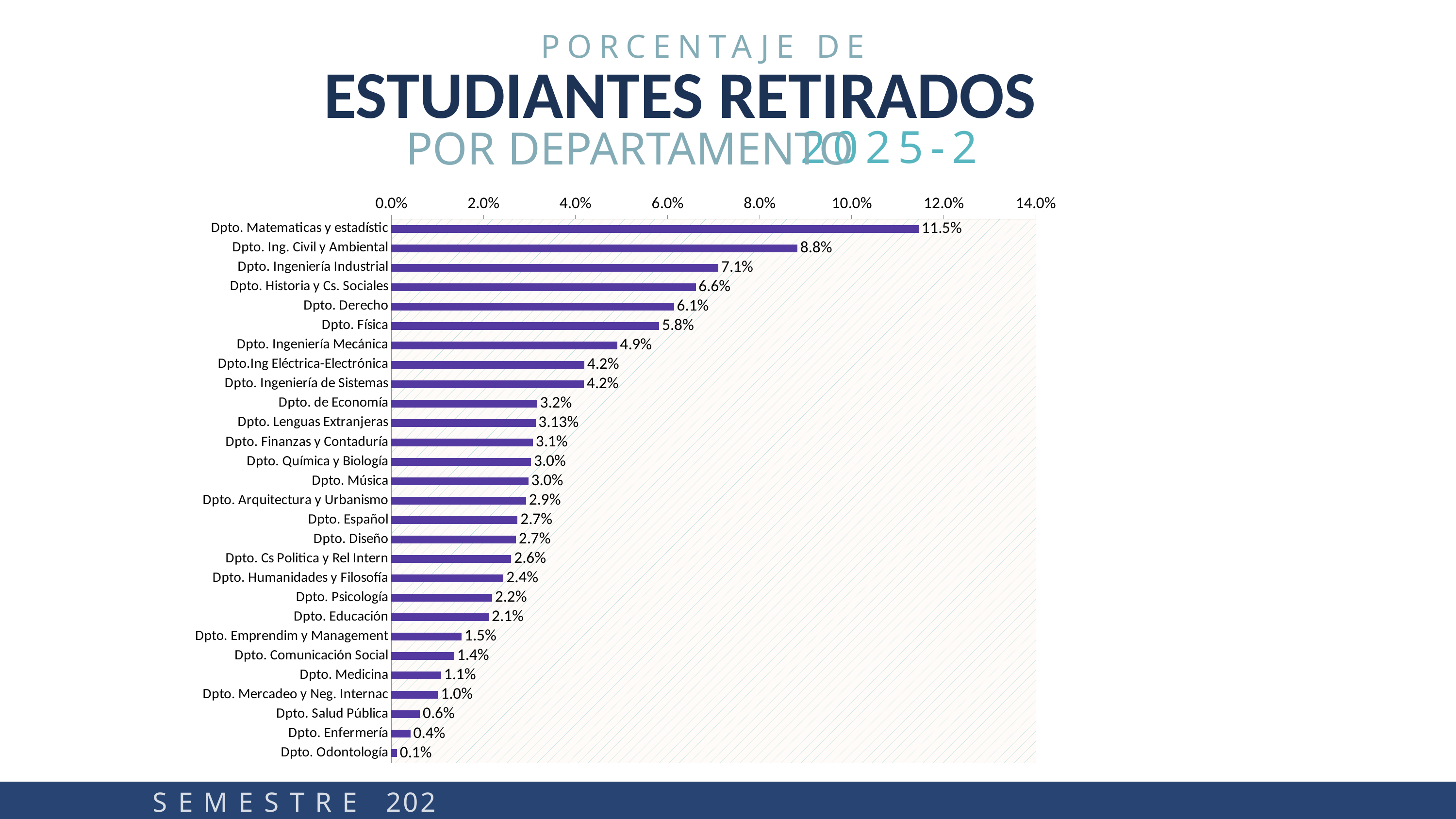
What is the difference between the values for Dpto. Matematicas y estadístic and Dpto. Ing. Civil y Ambiental? 2.7% Is the value for Dpto. Ingeniería Industrial greater or less than 6.0%? greater Which department has the highest percentage of withdrawn students? Dpto. Matematicas y estadístic What is the maximum value shown on the horizontal axis? 14.0% What is the value for Dpto. Lenguas Extranjeras? 3.13% Which is larger, the value for Dpto. Física or the value for Dpto. Ingeniería Mecánica? Dpto. Física What is the value for Dpto. Ing. Civil y Ambiental? 8.8% What kind of chart is shown on the slide? bar chart What is the value for Dpto. Medicina? 1.1% Which department has the lowest percentage of withdrawn students? Dpto. Odontología How many departments are shown in the chart? 28 What is the value for Dpto. Derecho? 6.1%